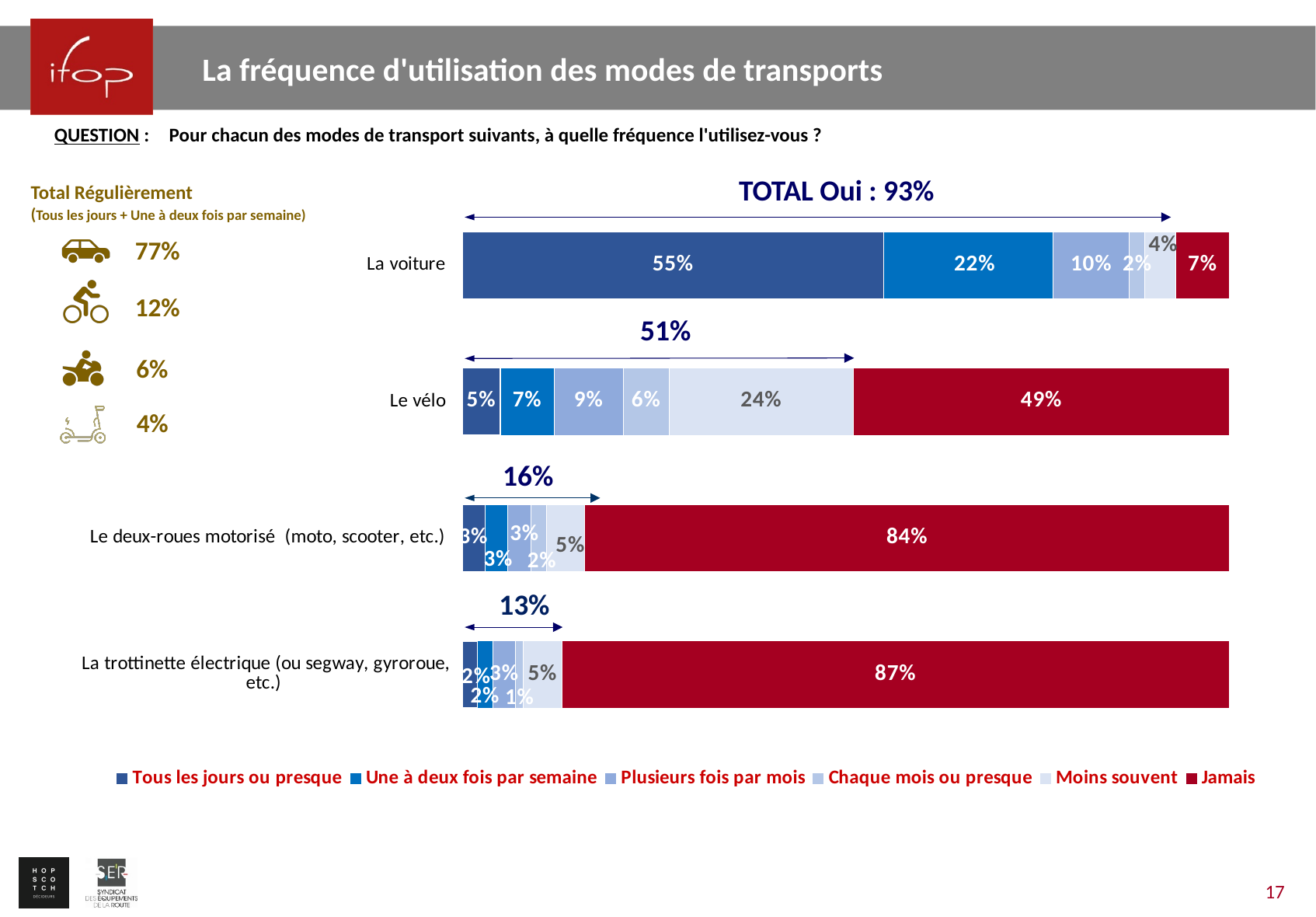
What percentage answered "Jamais" for Le vélo? 49% Which mode of transport has the highest "Jamais" percentage? La trottinette électrique (ou segway, gyroroue, etc.) What is the difference between the "Jamais" values for La trottinette électrique and Le deux-roues motorisé? 3 percentage points What kind of chart is shown on the slide? Stacked bar chart What is the "Moins souvent" value for Le vélo? 24% What is the "Tous les jours ou presque" value for Le vélo? 5% What is the value for "Tous les jours ou presque" for La voiture? 55% What percentage of respondents answered "Jamais" for La voiture? 7% Which has a larger "Une à deux fois par semaine" value, La voiture or Le vélo? La voiture How many series does the legend list? 6 Which mode of transport has the lowest "Jamais" percentage? La voiture How many modes of transport are shown in the chart? 4